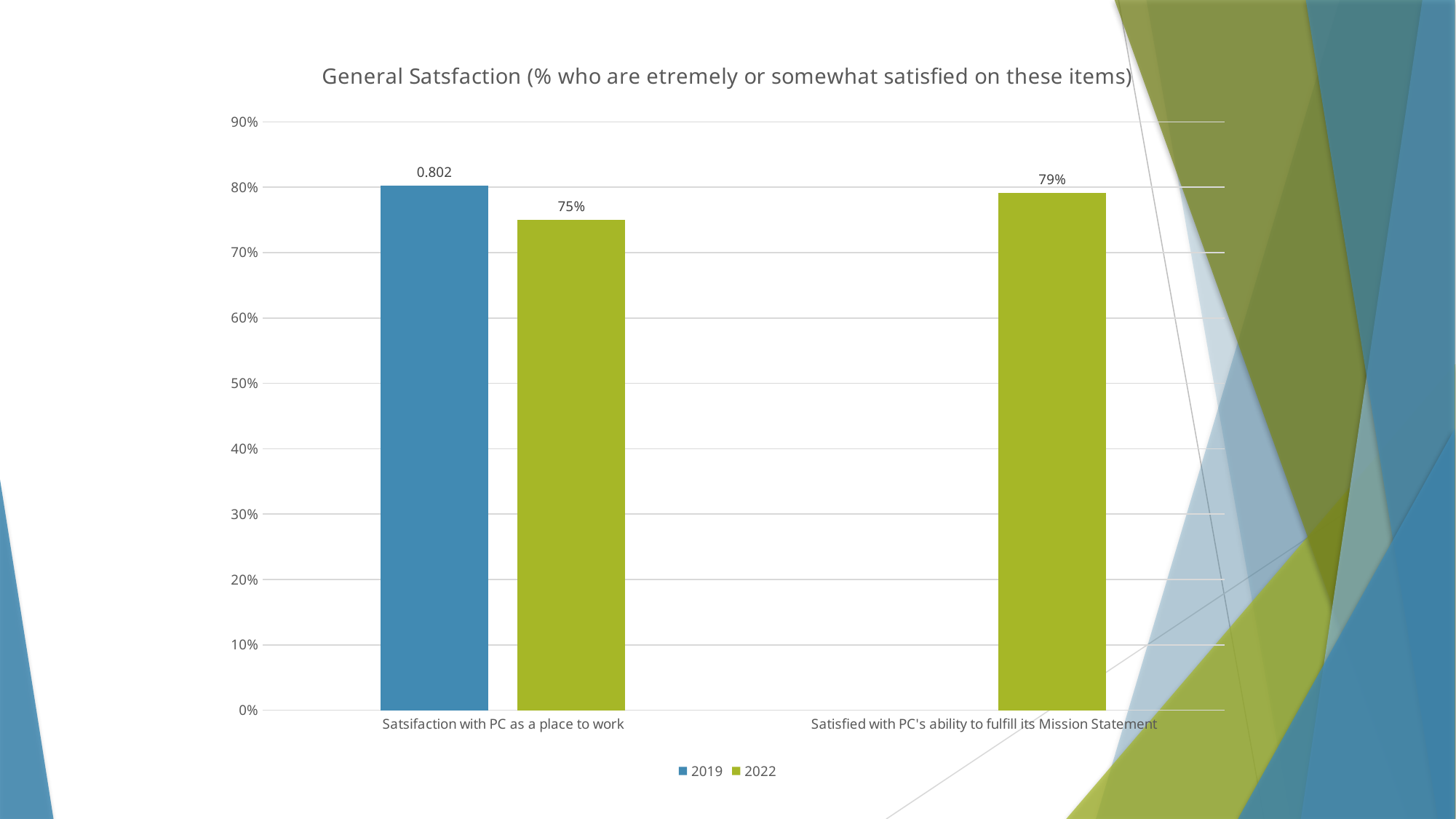
What is the 2019 value for Satsifaction with PC as a place to work? 0.802 Is the 2022 value for Satisfied with PC's ability to fulfill its Mission Statement greater or less than 80%? less What kind of chart is shown on the slide? bar chart What is the 2022 value for Satsifaction with PC as a place to work? 75% How many categories are shown on the x axis? 2 What is the 2022 value for Satisfied with PC's ability to fulfill its Mission Statement? 79% Which category has the lower 2022 value? Satsifaction with PC as a place to work How many series does the legend list? 2 What is the difference between the 2022 values for the two categories? 4% Which category has the higher 2022 value? Satisfied with PC's ability to fulfill its Mission Statement For Satsifaction with PC as a place to work, which series has the larger value, 2019 or 2022? 2019 Which series is shown in green? 2022